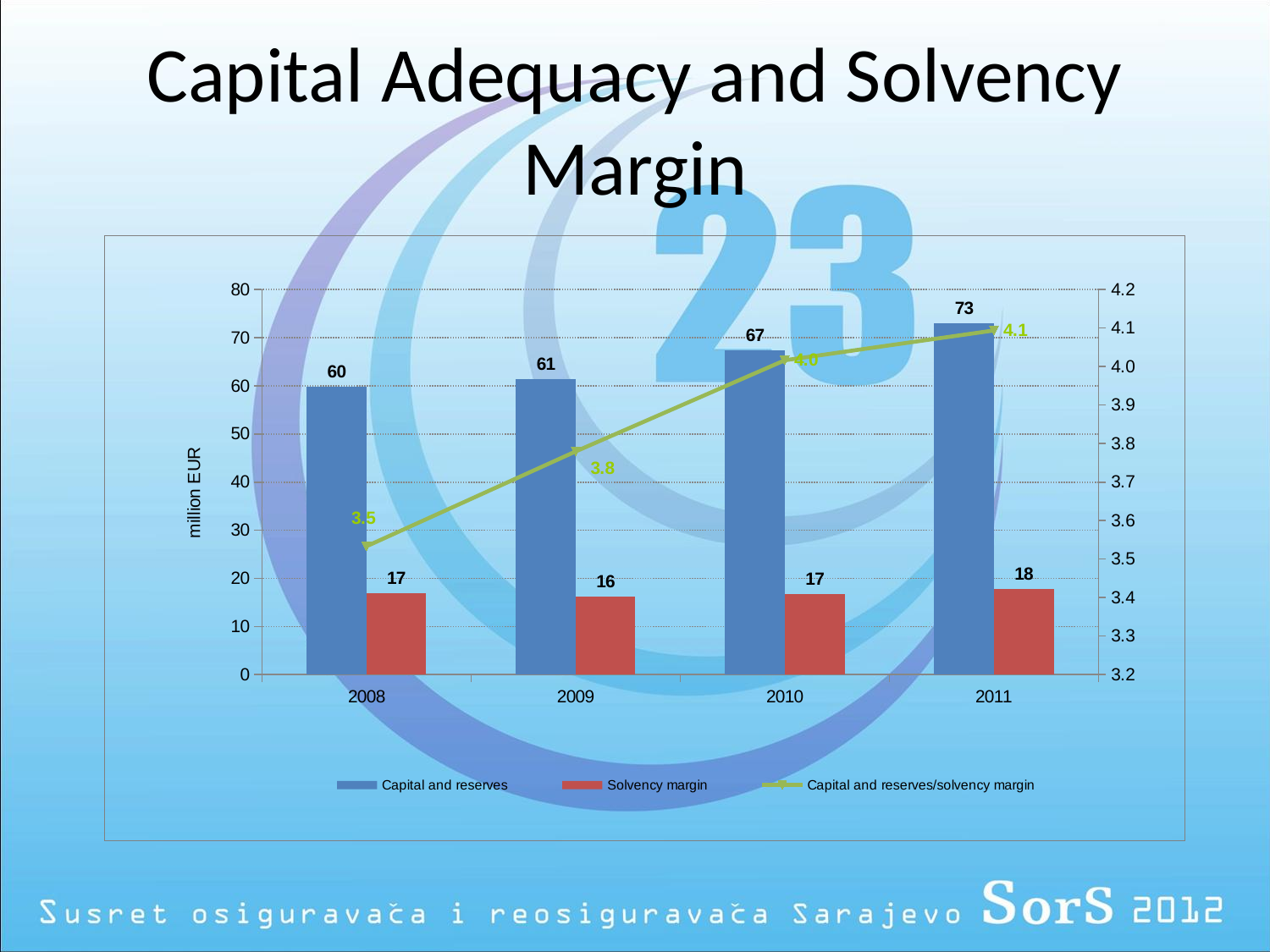
How many years are shown on the x axis? 4 In which year is the Solvency margin lowest? 2009 What is the difference between Capital and reserves in 2011 and in 2008? 13 How many series does the legend list? 3 What is the label of the left vertical axis? million EUR What is the Capital and reserves/solvency margin ratio in 2008? 3.5 Does the Capital and reserves/solvency margin line rise or fall from 2008 to 2011? rise What is the Solvency margin value for 2009? 16 What is the value of Capital and reserves in 2011? 73 In which year is Capital and reserves highest? 2011 Which is larger: Capital and reserves in 2009 or in 2010? 2010 What is the title of the slide containing the chart? Capital Adequacy and Solvency Margin